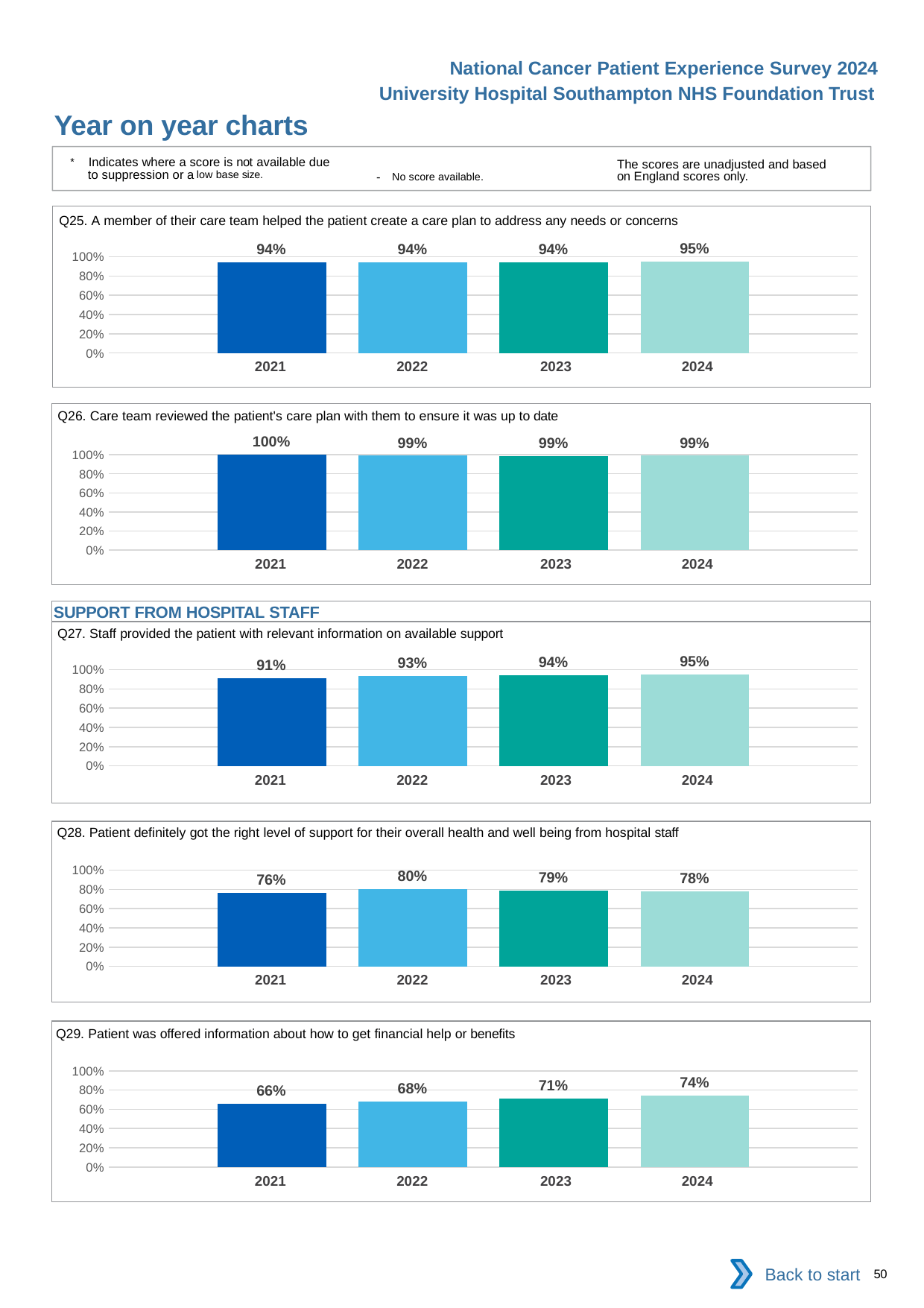
What kind of chart is the Q28 chart (right level of support from hospital staff)? bar chart In the Q27 chart (information on available support), what is the difference between the 2024 and 2021 values? 4% In the Q28 chart (right level of support from hospital staff), which year has the lowest value? 2021 In the Q29 chart (information about financial help or benefits), which is larger, the value for 2021 or the value for 2024? 2024 In the Q26 chart (care team reviewed the care plan), which year has the highest value? 2021 In the Q27 chart (information on available support), do the values rise or fall from 2021 to 2024? rise How many years are shown in the Q25 chart (care plan to address needs or concerns)? 4 In the Q26 chart (care team reviewed the care plan), what is the value for 2021? 100% In the Q29 chart (information about financial help or benefits), what is the difference between the 2024 and 2021 values? 8% In the Q28 chart (right level of support from hospital staff), what is the value for 2022? 80% In the Q29 chart (information about financial help or benefits), is the value for 2021 greater or less than 80%? less In the Q25 chart (care plan to address needs or concerns), what is the value for 2024? 95%